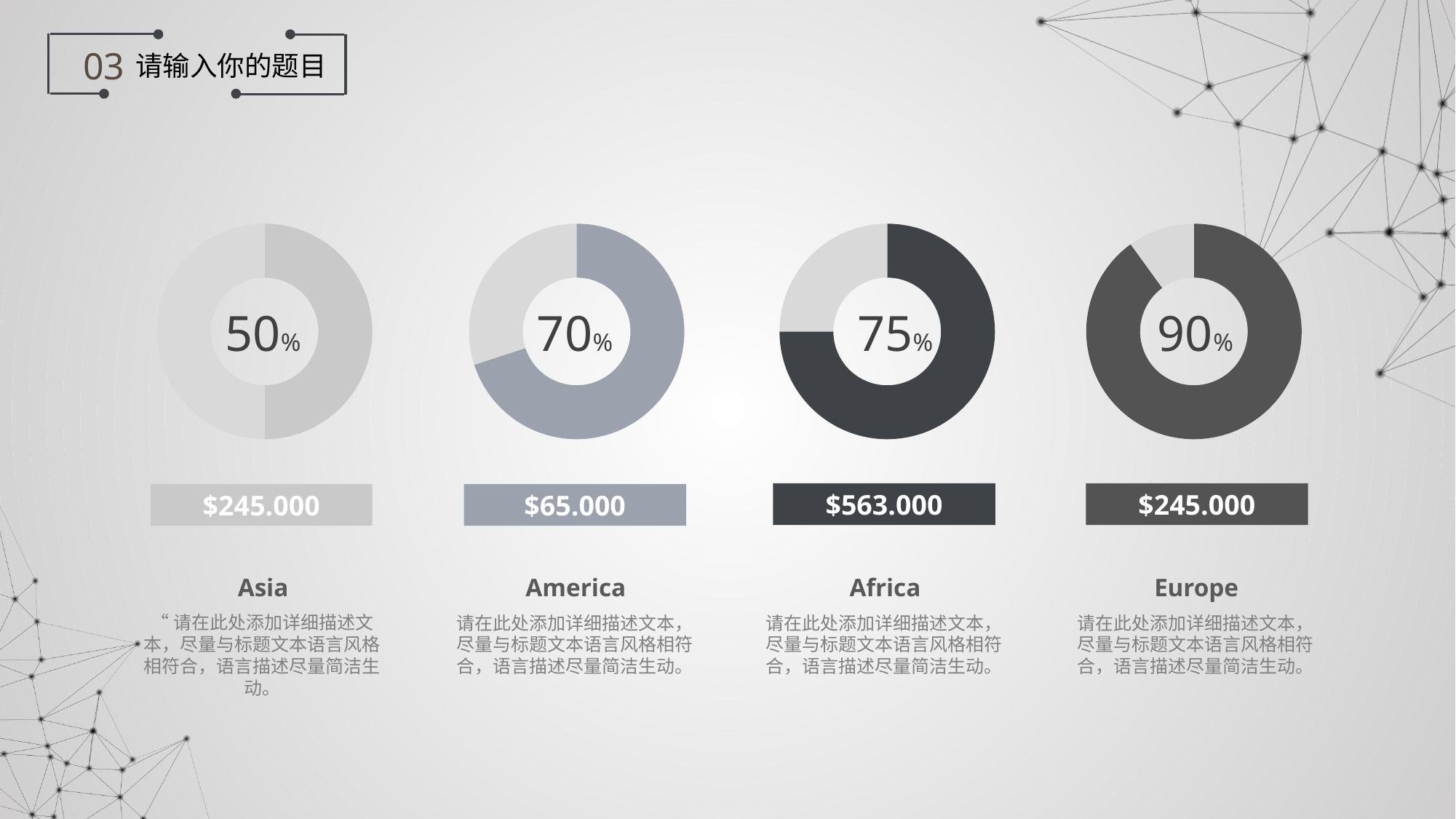
What dollar value is printed below the Africa donut chart? $563.000 What percentage is shown in the centre of the Asia donut chart? 50% What percentage is shown in the centre of the America donut chart? 70% How many donut charts are on the slide? 4 Which region's donut chart shows the highest percentage? Europe What kind of chart is used for each region on the slide? Donut chart Which shows a larger percentage, the America donut chart or the Africa donut chart? Africa What dollar value is printed below the America donut chart? $65.000 What percentage is shown in the centre of the Africa donut chart? 75% What is the difference between the percentage shown for Europe and the percentage shown for Asia? 40% Which region's donut chart shows the lowest percentage? Asia What percentage is shown in the centre of the Europe donut chart? 90%